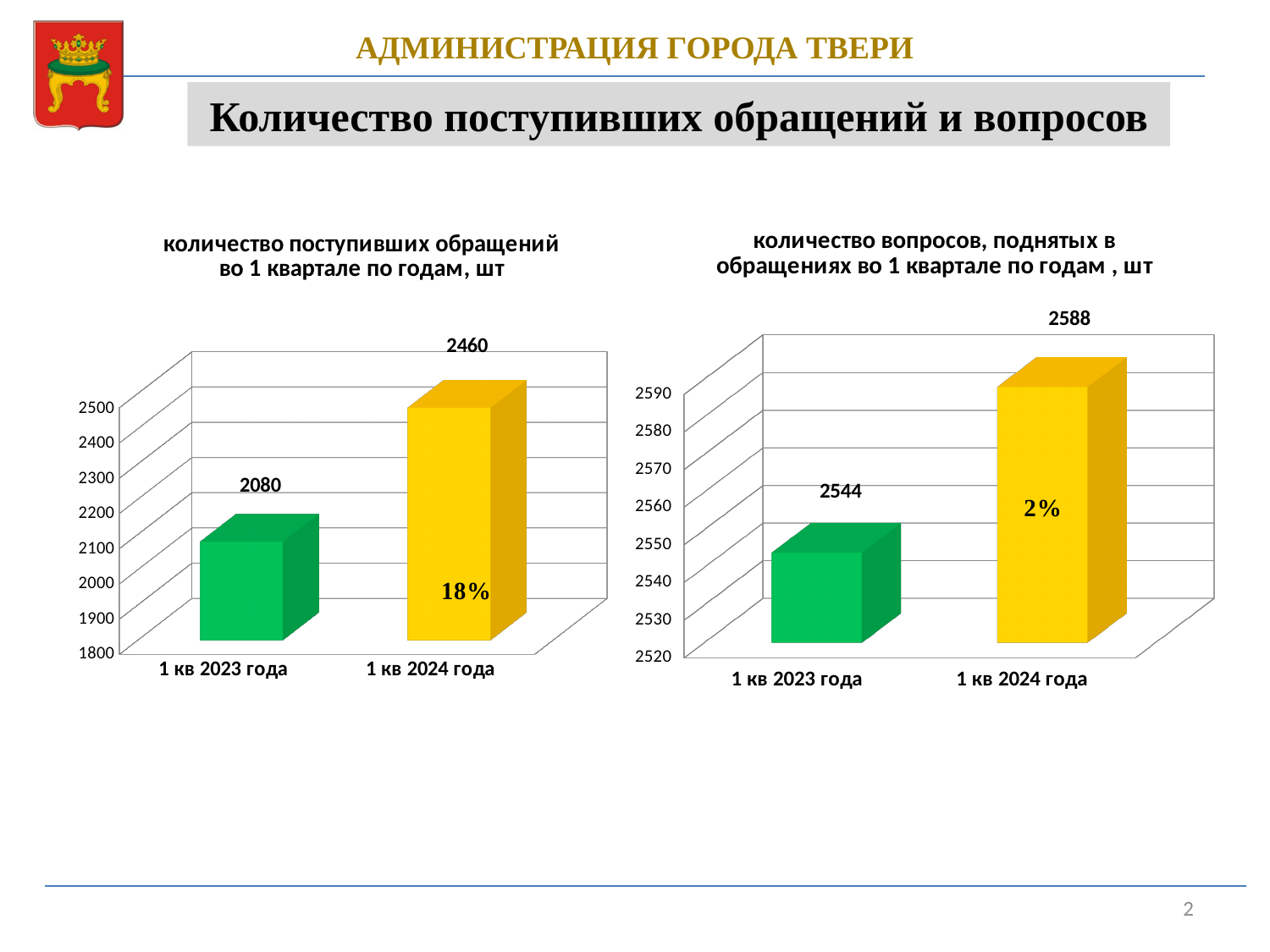
How many categories are shown in the right chart? 2 In the left chart (количество поступивших обращений во 1 квартале по годам, шт), what is the value for 1 кв 2023 года? 2080 In the right chart (количество вопросов, поднятых в обращениях во 1 квартале по годам, шт), what is the value for 1 кв 2024 года? 2588 In the right chart, what is the difference between the values for 1 кв 2024 года and 1 кв 2023 года? 44 In the left chart, which category has the highest value? 1 кв 2024 года In the left chart (количество поступивших обращений во 1 квартале по годам, шт), what is the value for 1 кв 2024 года? 2460 In the left chart, what percentage label is printed on the bar for 1 кв 2024 года? 18% What kind of chart is the left chart? bar chart In the right chart, which category has the lowest value? 1 кв 2023 года In the right chart, which is larger: the value for 1 кв 2023 года or 1 кв 2024 года? 1 кв 2024 года In the left chart, what is the difference between the values for 1 кв 2024 года and 1 кв 2023 года? 380 In the right chart (количество вопросов, поднятых в обращениях во 1 квартале по годам, шт), what is the value for 1 кв 2023 года? 2544